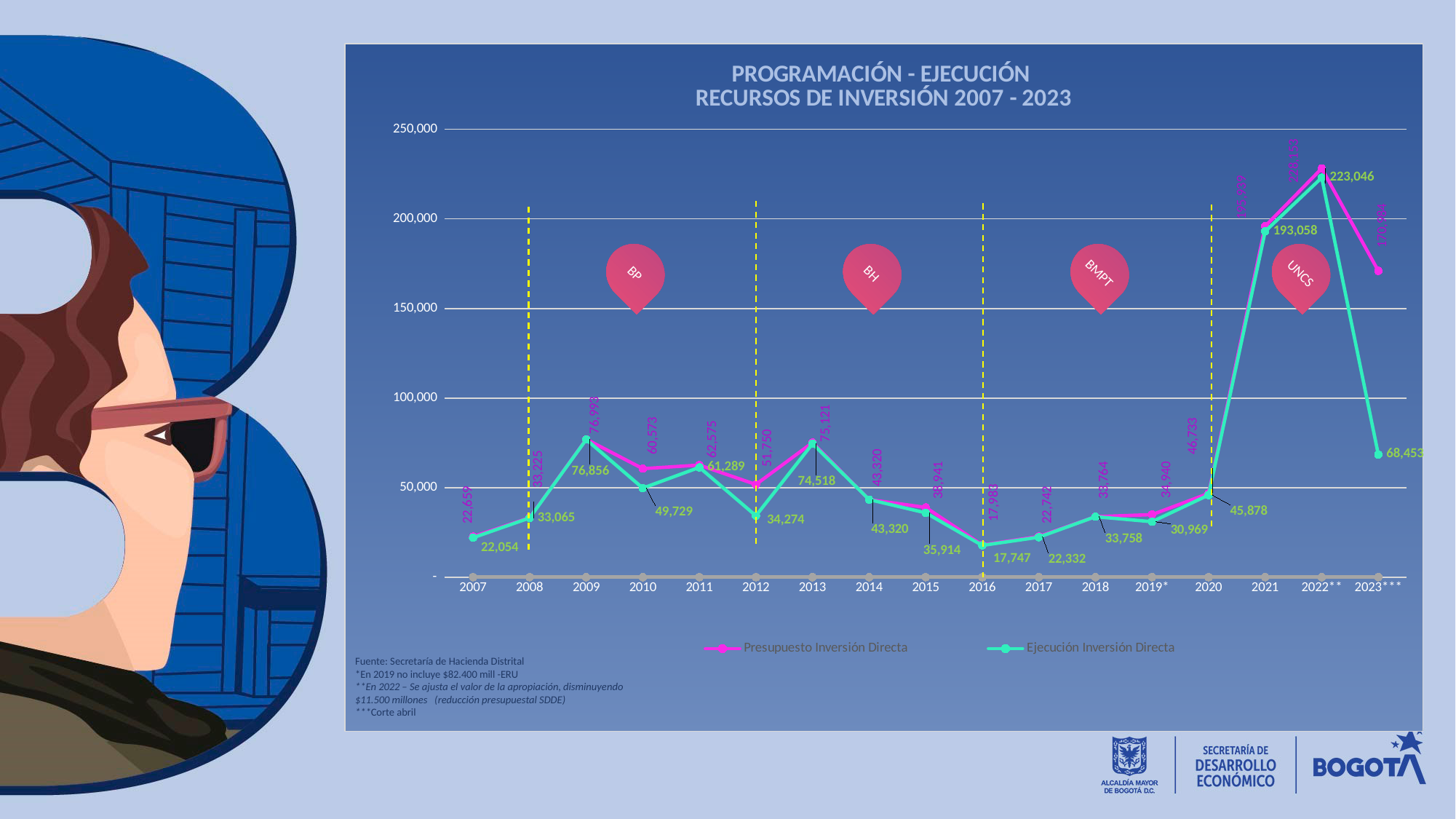
What is the value of Presupuesto Inversión Directa for 2013? 75,121 What is the value of Ejecución Inversión Directa for 2022**? 223,046 How many series does the legend list? 2 What is the title of the chart? PROGRAMACIÓN - EJECUCIÓN RECURSOS DE INVERSIÓN 2007 - 2023 What kind of chart is shown on the slide? line chart What is the value of Ejecución Inversión Directa for 2016? 17,747 In which year is Ejecución Inversión Directa highest? 2022** In which year is Ejecución Inversión Directa lowest? 2016 In 2010, which is larger: Presupuesto Inversión Directa or Ejecución Inversión Directa? Presupuesto Inversión Directa How many years are plotted along the x axis? 17 What is the difference between Presupuesto Inversión Directa and Ejecución Inversión Directa in 2012? 17,476 Is the value of Presupuesto Inversión Directa for 2022** greater or less than 200,000? greater